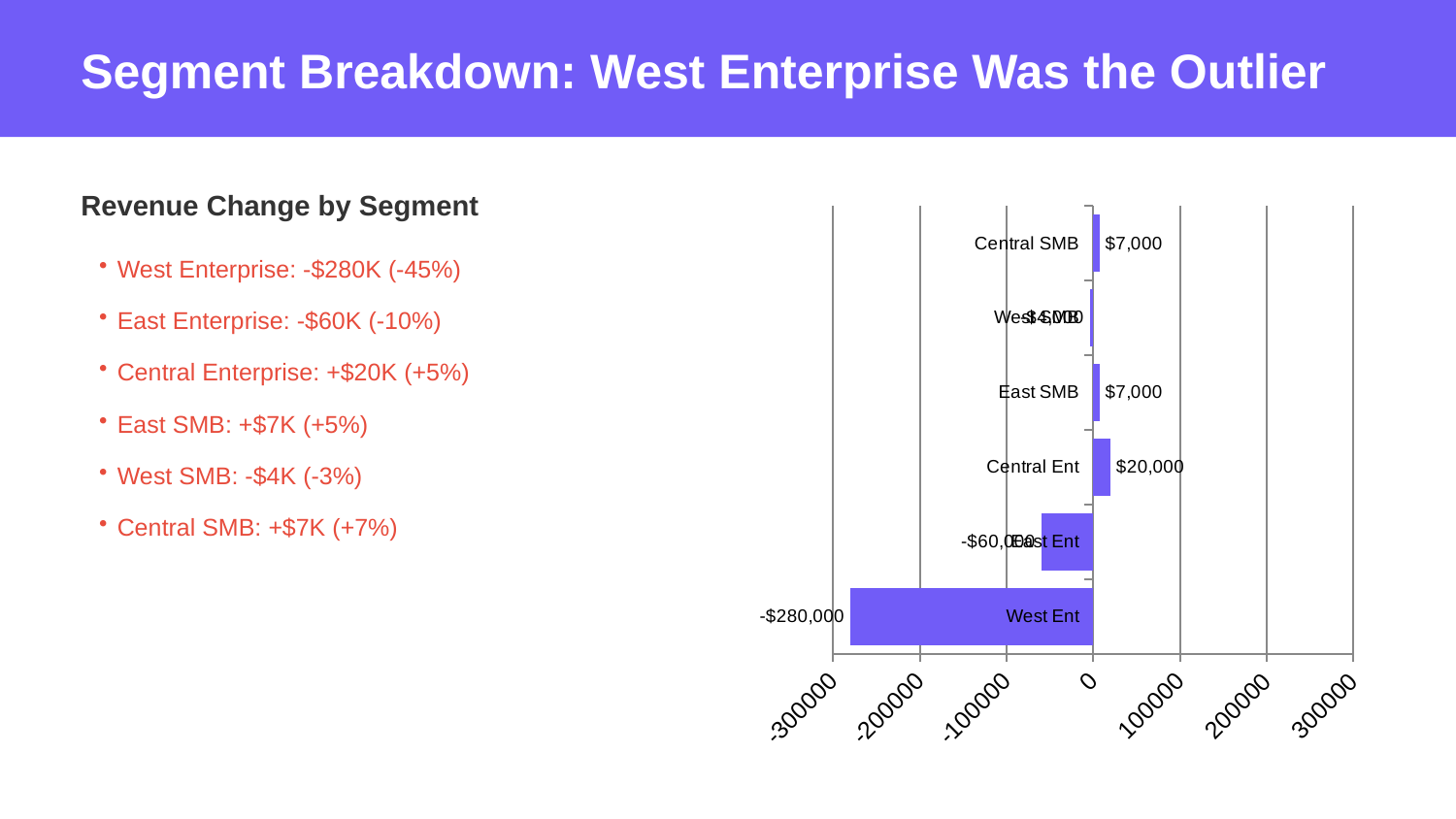
What is the lowest tick value shown on the x axis of the chart? -300000 What is the value shown for East SMB in the chart? $7,000 Which segment has the highest value in the chart? Central Ent How many segments (categories) are plotted in the chart? 6 What is the difference between the values for Central Ent and Central SMB? $13,000 Which is larger in the chart, the value for Central Ent or the value for East SMB? Central Ent What is the value shown for Central SMB in the chart? $7,000 What kind of chart is shown on the slide? bar chart Is the value for East Ent greater or less than -100000? greater Which segment has the lowest value in the chart? West Ent What is the value shown for West Ent in the chart? -$280,000 What is the value shown for Central Ent in the chart? $20,000